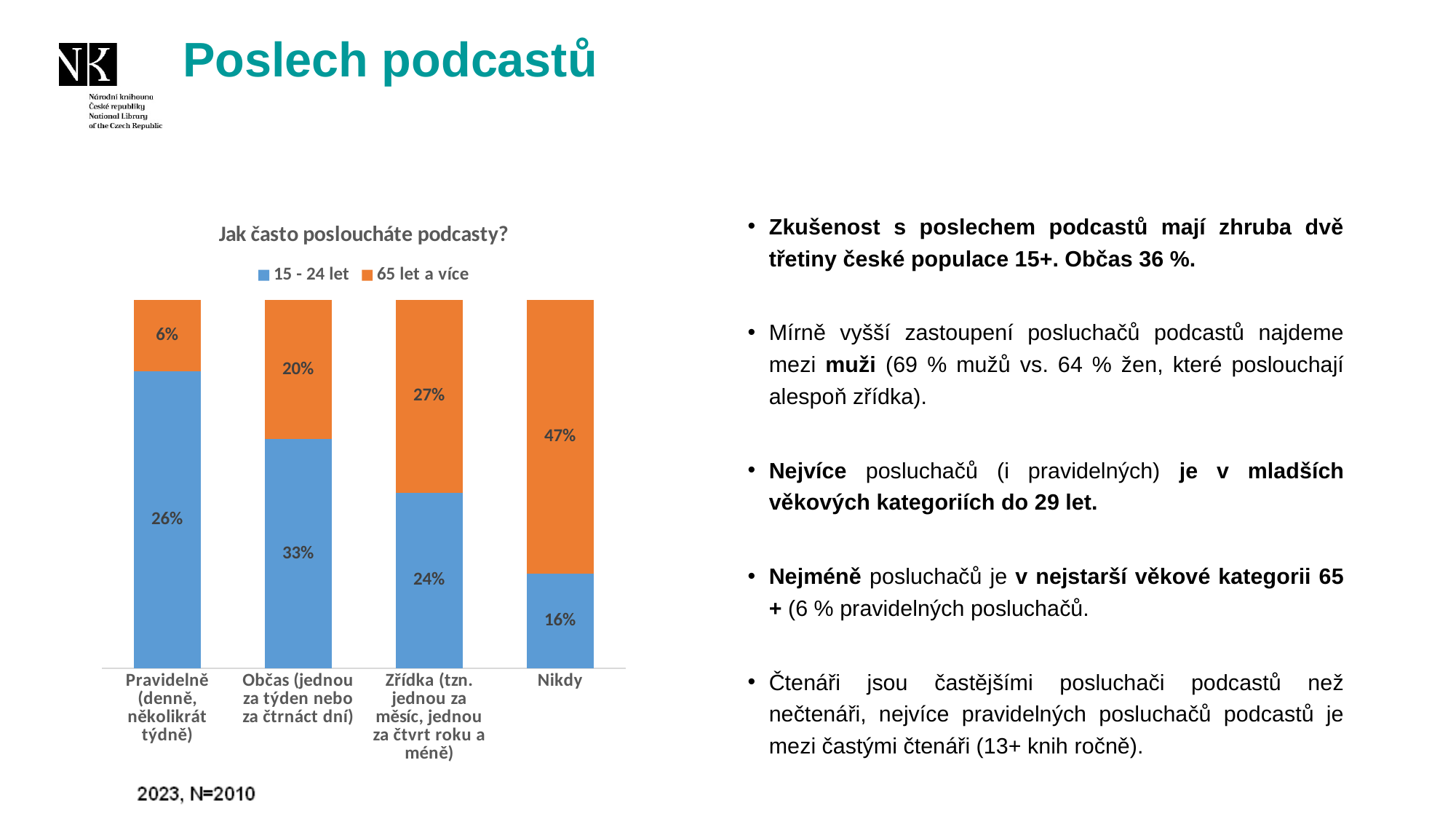
How many series does the chart legend list? 2 What is the title of the chart? Jak často posloucháte podcasty? What is the value for the 65 let a více series in the Občas category? 20% What kind of chart is shown on the slide? Stacked bar chart How many categories are shown on the x axis of the chart? 4 What is the difference between the 65 let a více value and the 15 - 24 let value in the Nikdy category? 31% In the Pravidelně category, which series has the larger value: 15 - 24 let or 65 let a více? 15 - 24 let In which category is the 65 let a více series highest? Nikdy In which category is the 15 - 24 let series lowest? Nikdy What is the value for the 65 let a více series in the Nikdy category? 47% What is the value for the 15 - 24 let series in the Pravidelně category? 26% What is the value for the 15 - 24 let series in the Zřídka category? 24%